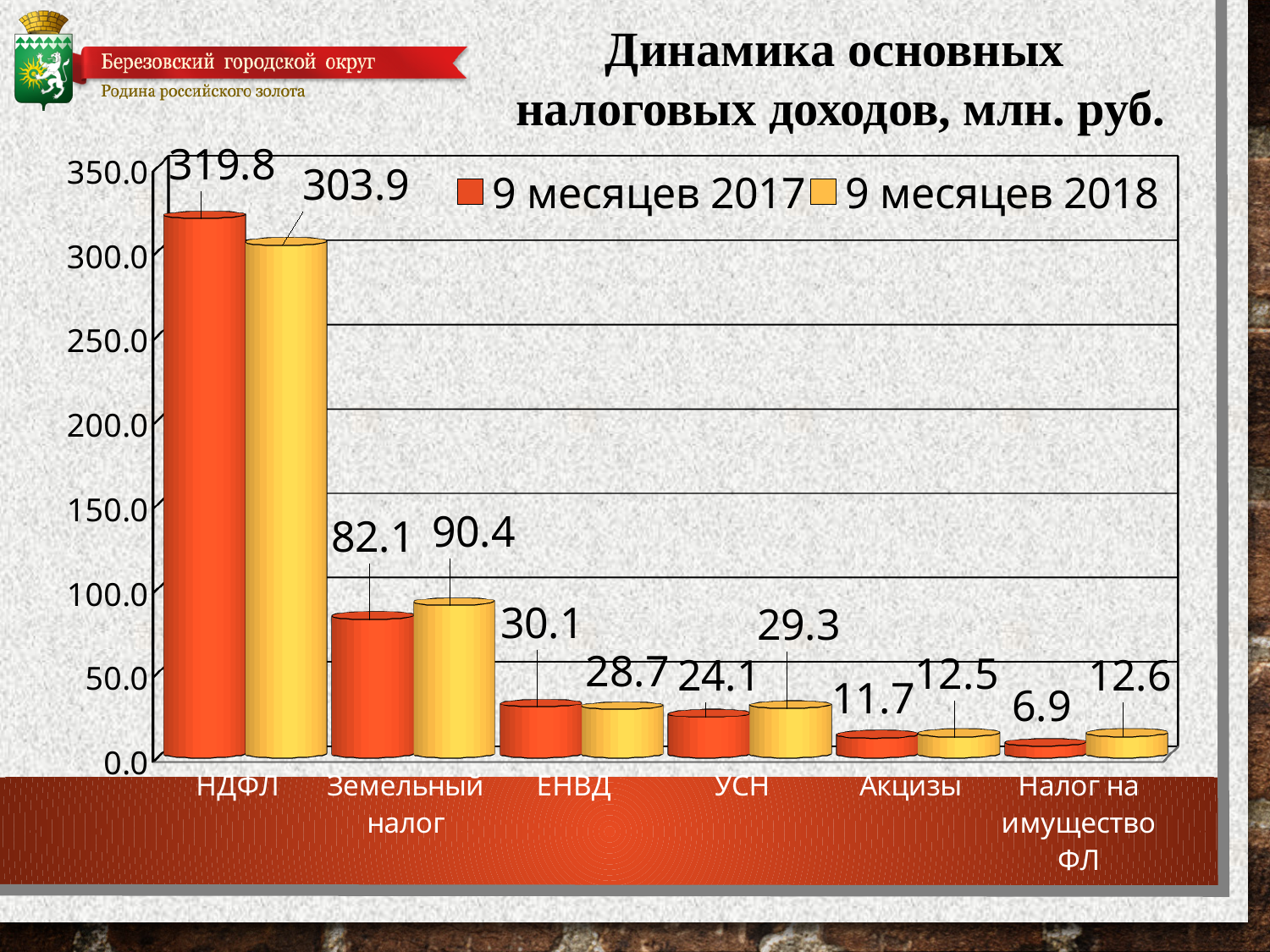
What kind of chart is shown on the slide? Bar chart What is the value for Налог на имущество ФЛ in the 9 месяцев 2018 series? 12.6 Which category has the highest value in the 9 месяцев 2018 series? НДФЛ What is the value for Земельный налог in the 9 месяцев 2018 series? 90.4 How many categories are shown on the x axis? 6 Is the value for ЕНВД in the 9 месяцев 2017 series greater or less than 50.0? less How many series does the legend list? 2 What is the difference between the 9 месяцев 2017 and 9 месяцев 2018 values for НДФЛ? 15.9 For Акцизы, which series has the larger value: 9 месяцев 2017 or 9 месяцев 2018? 9 месяцев 2018 What is the value for НДФЛ in the 9 месяцев 2017 series? 319.8 What is the value for УСН in the 9 месяцев 2017 series? 24.1 Which category has the lowest value in the 9 месяцев 2017 series? Налог на имущество ФЛ